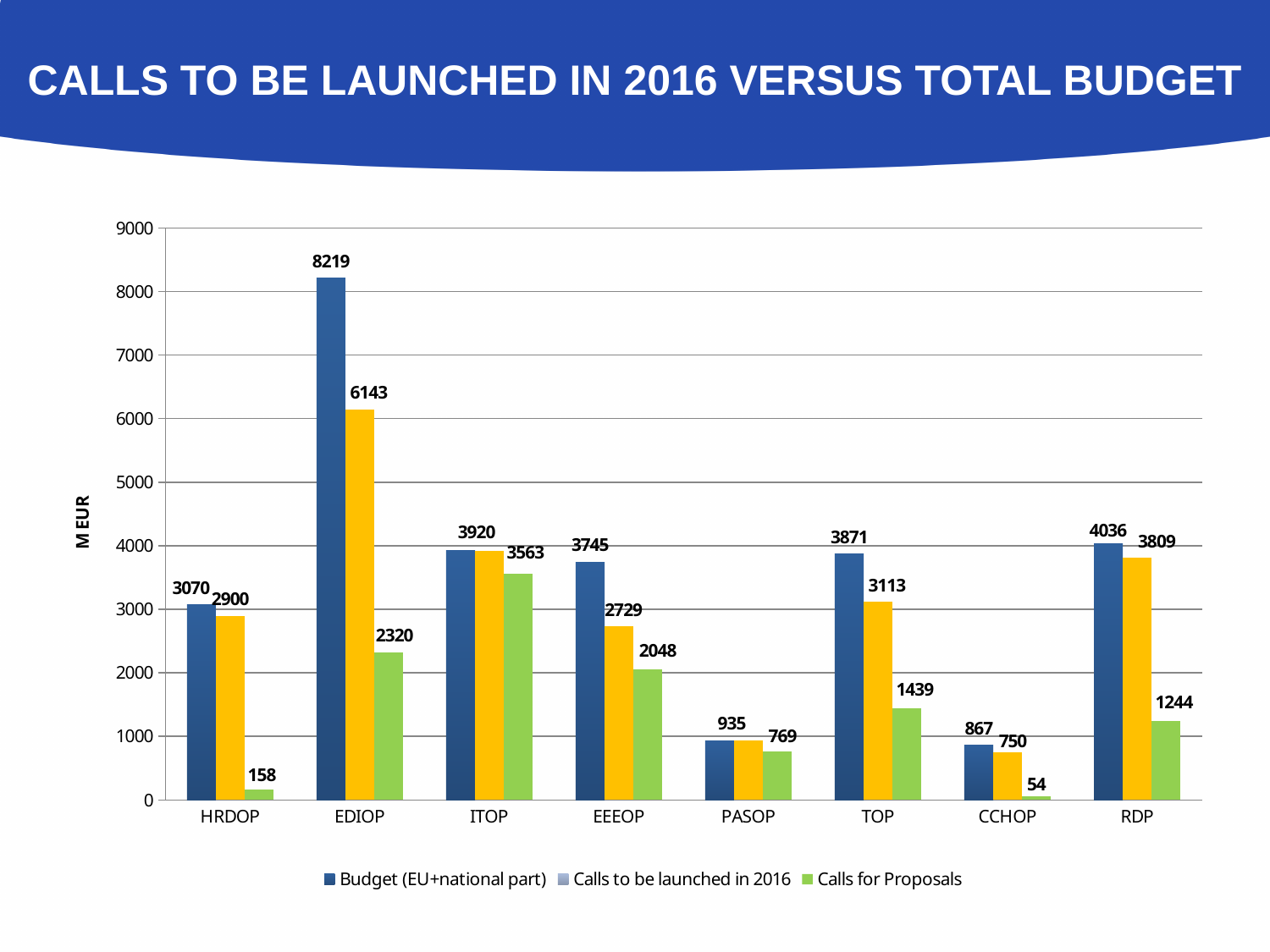
Which category has the lowest Calls for Proposals value? CCHOP What is the Calls for Proposals value for CCHOP? 54 What kind of chart is shown on the slide? bar chart Which category has the highest Budget (EU+national part)? EDIOP What is the Calls to be launched in 2016 value for TOP? 3113 How many categories are shown on the x axis? 8 Which is larger: the Calls for Proposals value for ITOP or for EEEOP? ITOP How many series does the legend list? 3 What is the difference between the Budget (EU+national part) and the Calls to be launched in 2016 for EDIOP? 2076 Which category has the highest Calls for Proposals value? ITOP Is the Budget (EU+national part) value for RDP greater or less than 4000? greater What is the Budget (EU+national part) value for EDIOP? 8219